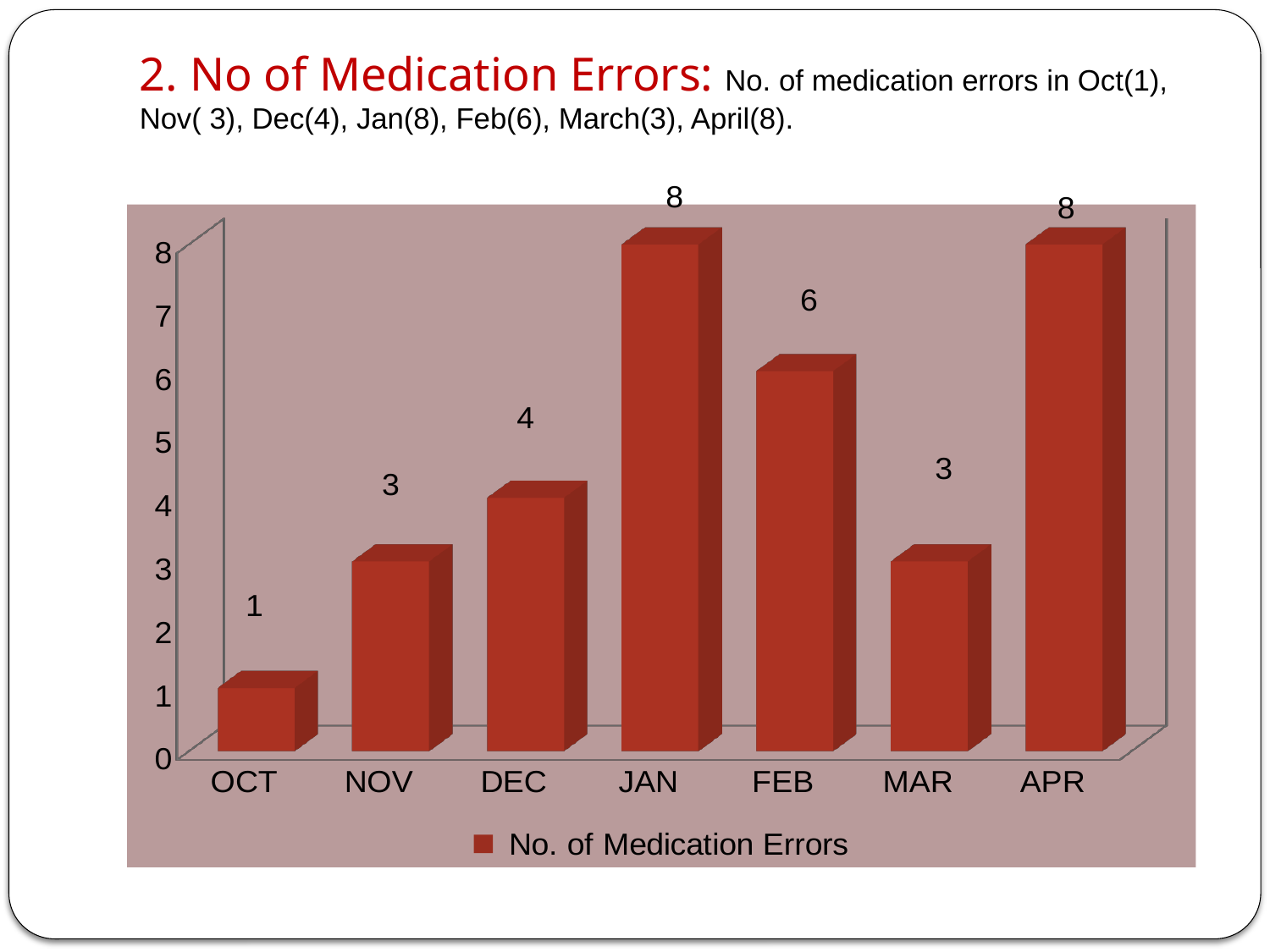
How many months are shown on the x axis? 7 What is the number of medication errors for OCT? 1 What is the difference in medication errors between JAN and FEB? 2 What is the number of medication errors for JAN? 8 What is the difference in medication errors between DEC and OCT? 3 What is the legend entry for the series shown? No. of Medication Errors Which has more medication errors, DEC or MAR? DEC Which month has the lowest number of medication errors? OCT How many series does the legend list? 1 What is the number of medication errors for FEB? 6 Which has more medication errors, FEB or NOV? FEB What kind of chart is shown on the slide? Bar chart